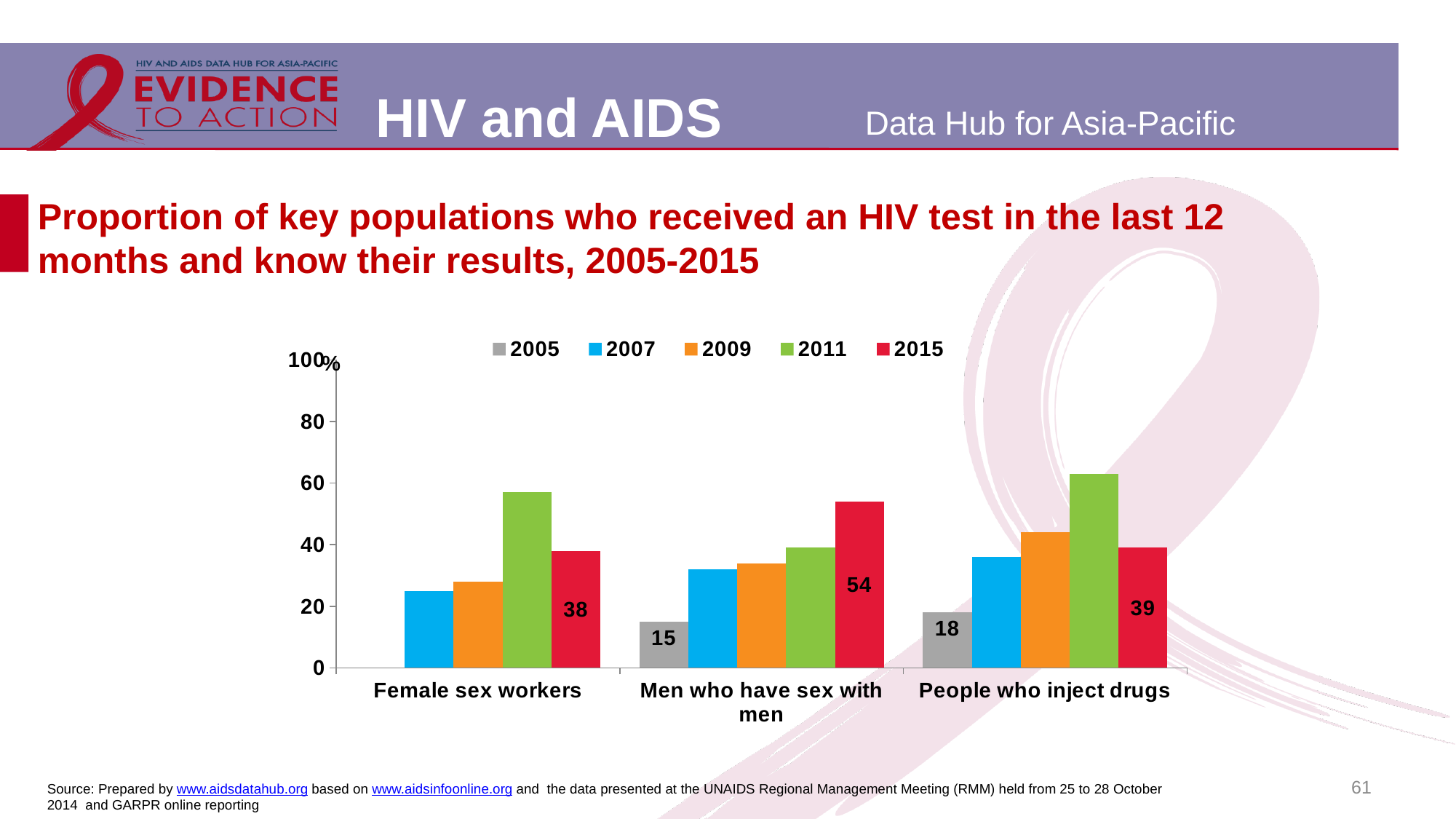
What kind of chart is shown on the slide? bar chart Is the 2011 value for Female sex workers greater or less than 40? greater What is the 2005 value for Men who have sex with men? 15 Which category has the highest 2015 value? Men who have sex with men What is the 2015 value for Men who have sex with men? 54 What is the 2005 value for People who inject drugs? 18 What is the difference between the 2015 values for Men who have sex with men and Female sex workers? 16 Which has the larger 2005 value: Men who have sex with men or People who inject drugs? People who inject drugs By how much did the value for People who inject drugs increase from 2005 to 2015? 21 How many series does the legend list? 5 What is the 2015 value for Female sex workers? 38 How many population categories are shown on the x axis? 3